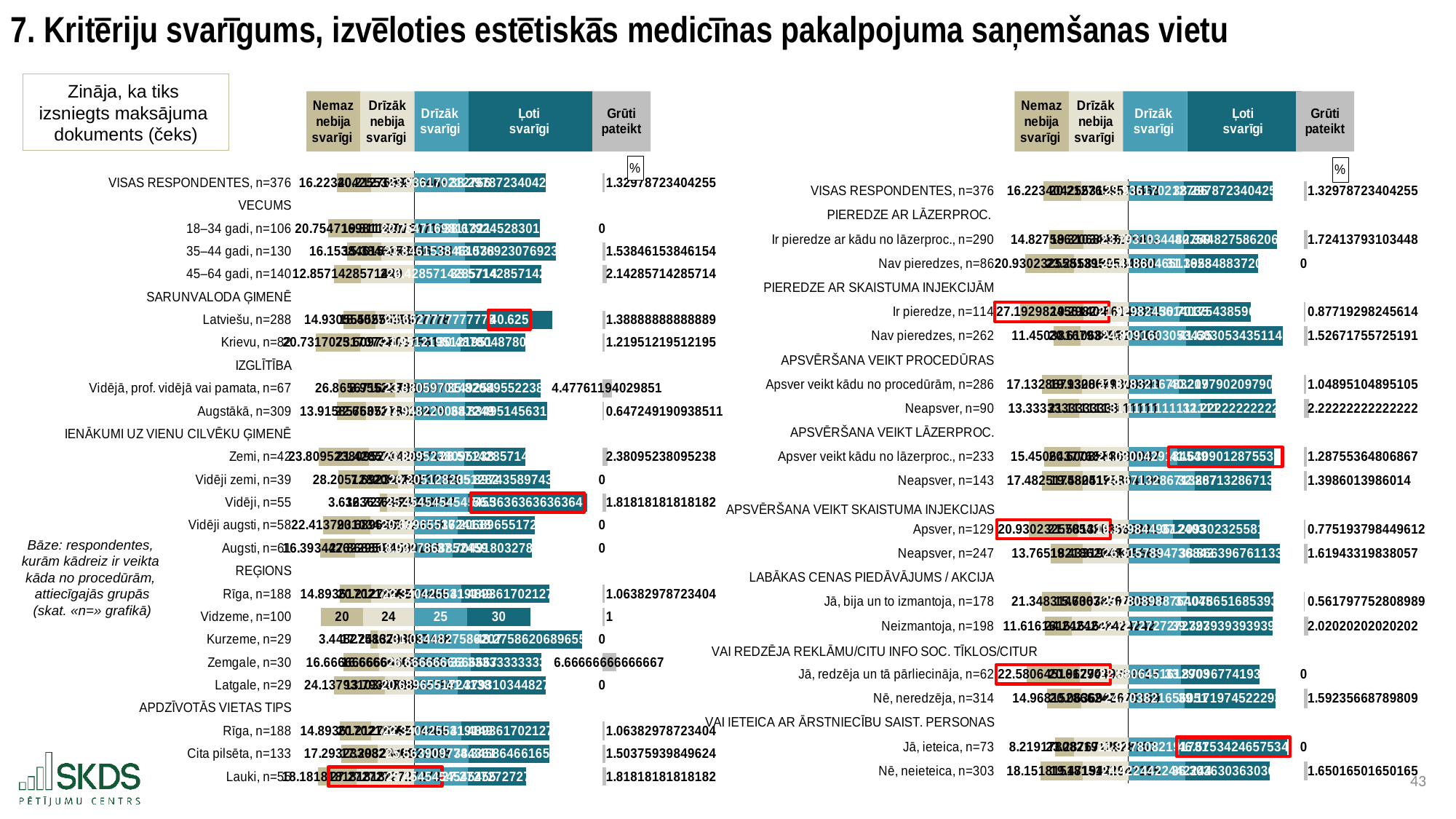
In the left chart, what is the 'Drīzāk svarīgi' value for 'Vidzeme, n=100'? 25 In the left chart, what is the 'Grūti pateikt' value for 'VISAS RESPONDENTES, n=376'? 1.32978723404255 What kind of chart is used on the left side of the slide? bar chart In the right chart, what is the 'Grūti pateikt' value for 'Neapsver, n=90'? 2.22222222222222 In the left chart, which category has the highest 'Grūti pateikt' value? Zemgale, n=30 In the left chart, what is the 'Ļoti svarīgi' value for 'Vidzeme, n=100'? 30 In the left chart, what is the 'Ļoti svarīgi' value for 'Latviešu, n=288'? 40.625 How many series does the legend of the left chart list? 5 In the left chart, what is the difference between the 'Ļoti svarīgi' and 'Nemaz nebija svarīgi' values for 'Vidzeme, n=100'? 10 In the left chart, what is the 'Grūti pateikt' value for 'Zemgale, n=30'? 6.66666666666667 In the right chart, which has the larger 'Grūti pateikt' value: 'Jā, bija un to izmantoja, n=178' or 'Neizmantoja, n=198'? Neizmantoja, n=198 In the left chart, what is the 'Nemaz nebija svarīgi' value for 'Vidzeme, n=100'? 20